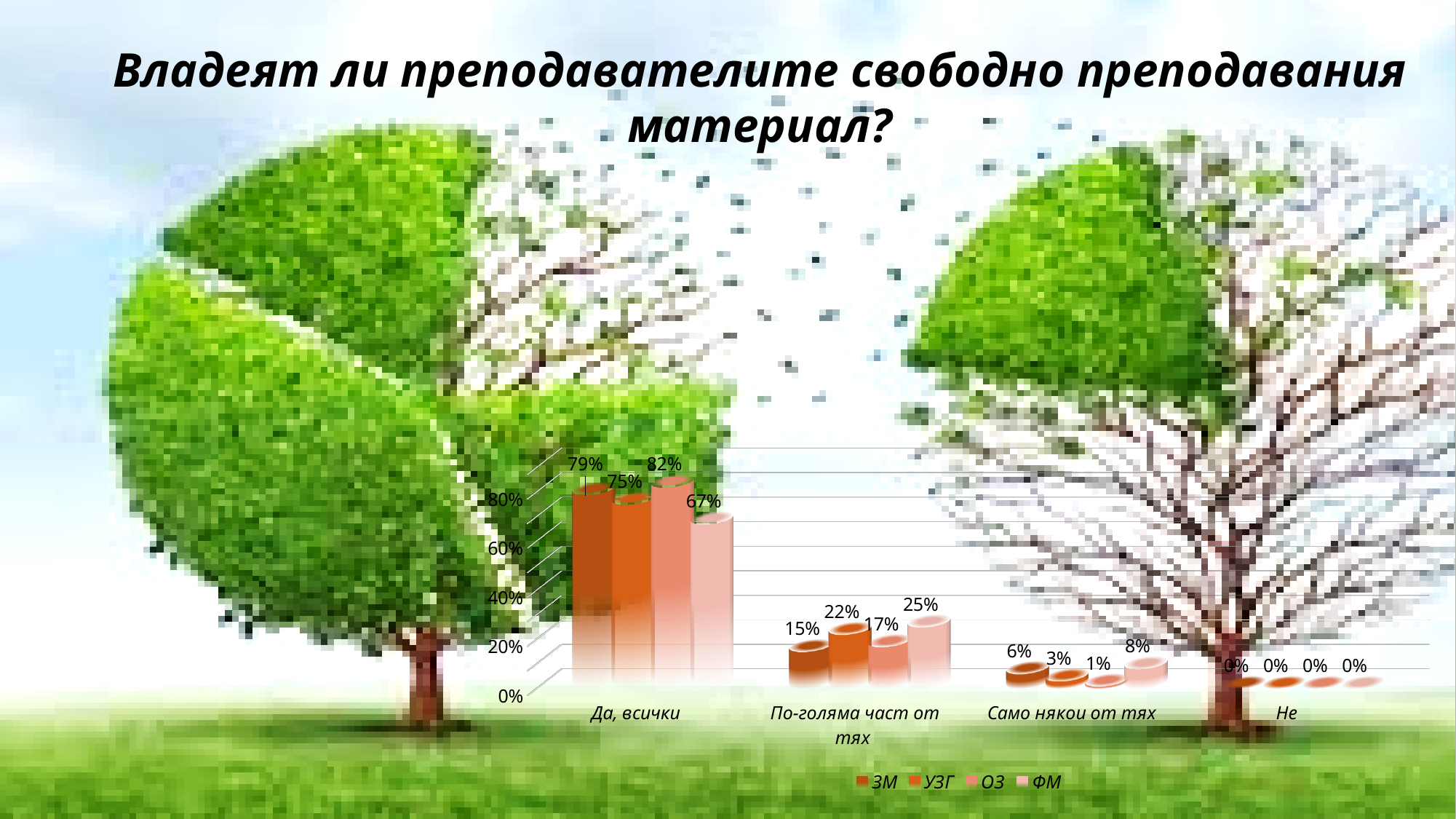
How many categories are shown on the x axis? 4 What is the value for ЗМ in the category "Да, всички"? 79% How many series does the legend list? 4 What is the difference between the ОЗ and ФМ values in the category "Да, всички"? 15% Which series has the lowest value in the category "Само някои от тях"? ОЗ What is the value for ФМ in the category "По-голяма част от тях"? 25% Which series has the highest value in the category "Да, всички"? ОЗ Which is larger in the category "По-голяма част от тях": the value for УЗГ or the value for ОЗ? УЗГ Which series is listed first in the legend? ЗМ What is the value for all four series in the category "Не"? 0% What is the value for ОЗ in the category "Само някои от тях"? 1% What kind of chart is shown on the slide? bar chart